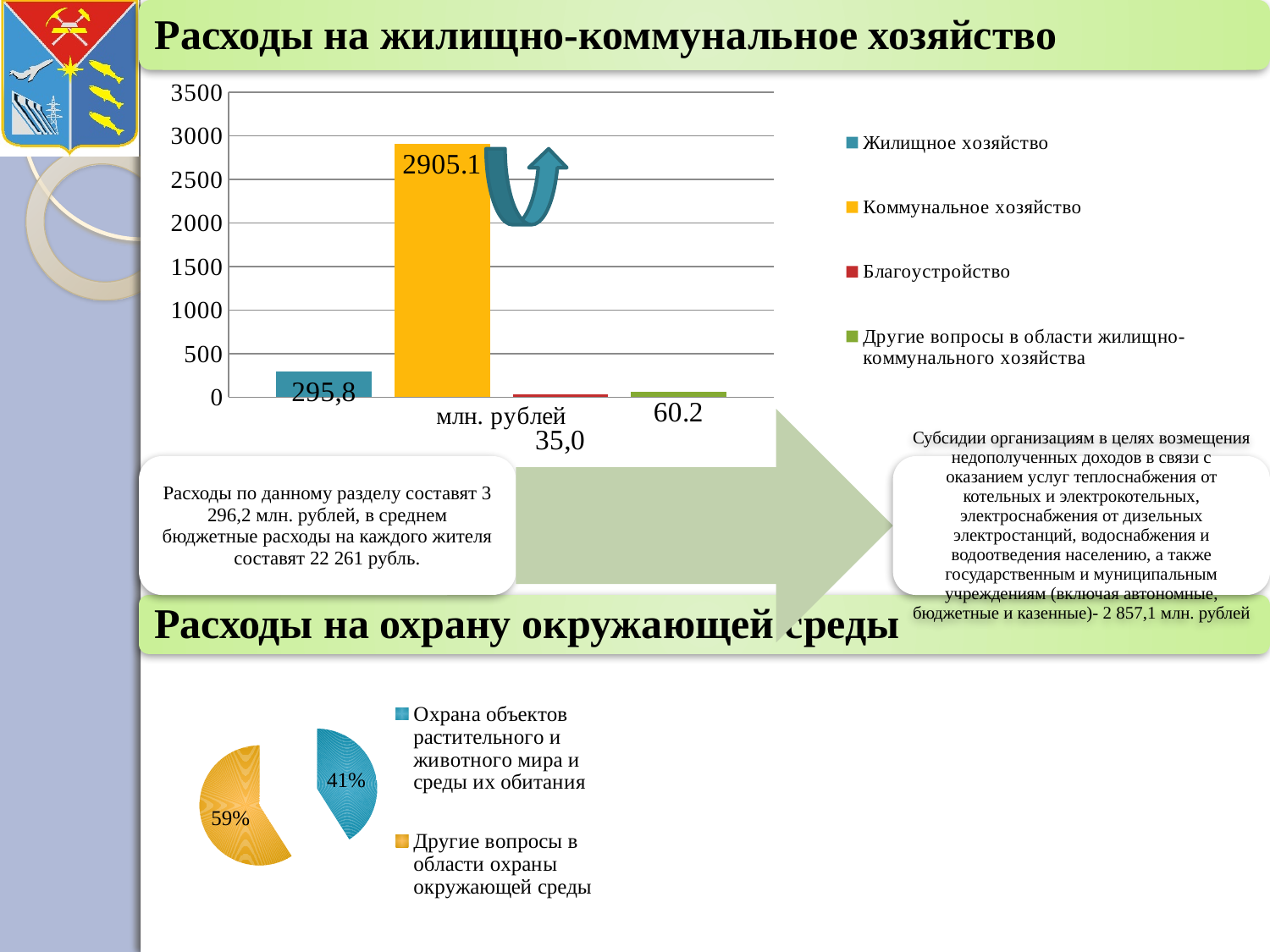
In the bar chart under "Расходы на жилищно-коммунальное хозяйство", which series has the lowest value? Благоустройство In the bar chart under "Расходы на жилищно-коммунальное хозяйство", what is the value for Жилищное хозяйство? 295,8 In the pie chart under "Расходы на охрану окружающей среды", what share is Охрана объектов растительного и животного мира и среды их обитания? 41% What kind of chart is shown under "Расходы на охрану окружающей среды"? Pie chart In the pie chart under "Расходы на охрану окружающей среды", what share is Другие вопросы в области охраны окружающей среды? 59% In the bar chart under "Расходы на жилищно-коммунальное хозяйство", which series has the highest value? Коммунальное хозяйство How many series does the legend of the bar chart under "Расходы на жилищно-коммунальное хозяйство" list? 4 In the bar chart under "Расходы на жилищно-коммунальное хозяйство", is the value for Коммунальное хозяйство greater or less than 2500? greater In the bar chart under "Расходы на жилищно-коммунальное хозяйство", what is the value for Другие вопросы в области жилищно-коммунального хозяйства? 60.2 In the bar chart under "Расходы на жилищно-коммунальное хозяйство", what is the value for Благоустройство? 35,0 In the bar chart under "Расходы на жилищно-коммунальное хозяйство", what is the value for Коммунальное хозяйство? 2905.1 In the bar chart under "Расходы на жилищно-коммунальное хозяйство", which is larger: Жилищное хозяйство or Другие вопросы в области жилищно-коммунального хозяйства? Жилищное хозяйство